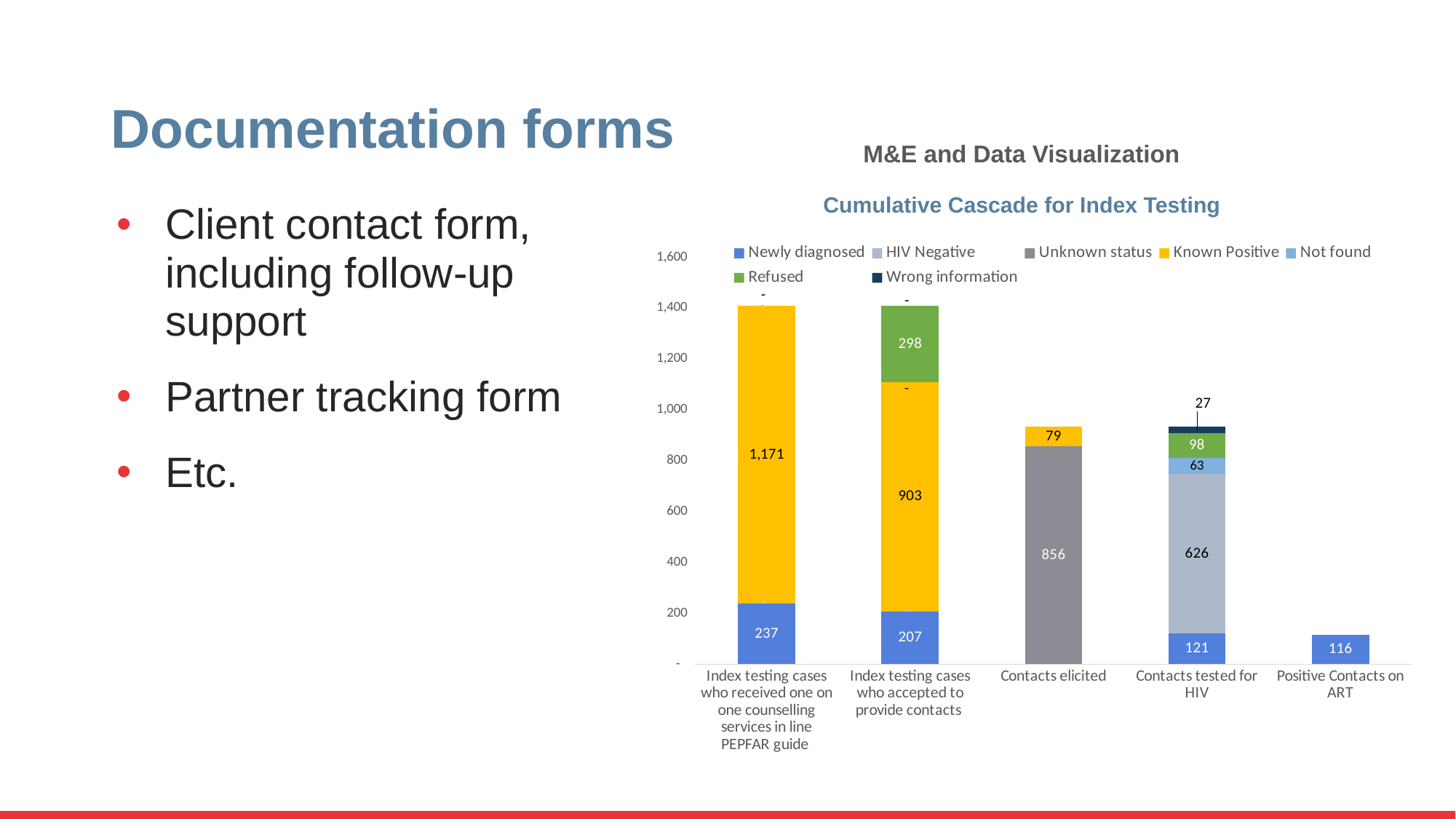
How many categories are shown on the x axis of the 'Cumulative Cascade for Index Testing' chart? 5 What is the Unknown status value for 'Contacts elicited'? 856 What is the total of the stacked bar for 'Contacts tested for HIV'? 935 What is the Refused value for 'Index testing cases who accepted to provide contacts'? 298 What is the Known Positive value for 'Index testing cases who received one on one counselling services in line PEPFAR guide'? 1,171 What is the Newly diagnosed value for 'Positive Contacts on ART'? 116 What is the Wrong information value for 'Contacts tested for HIV'? 27 How many series does the legend of the 'Cumulative Cascade for Index Testing' chart list? 7 What is the HIV Negative value for 'Contacts tested for HIV'? 626 What is the difference between the Newly diagnosed values for 'Index testing cases who received one on one counselling services in line PEPFAR guide' (237) and 'Index testing cases who accepted to provide contacts' (207)? 30 What type of chart is shown under the title 'Cumulative Cascade for Index Testing'? Stacked bar chart Which is larger: the Known Positive value for 'Contacts elicited' or the Refused value for 'Contacts tested for HIV'? Refused value for 'Contacts tested for HIV' (98)